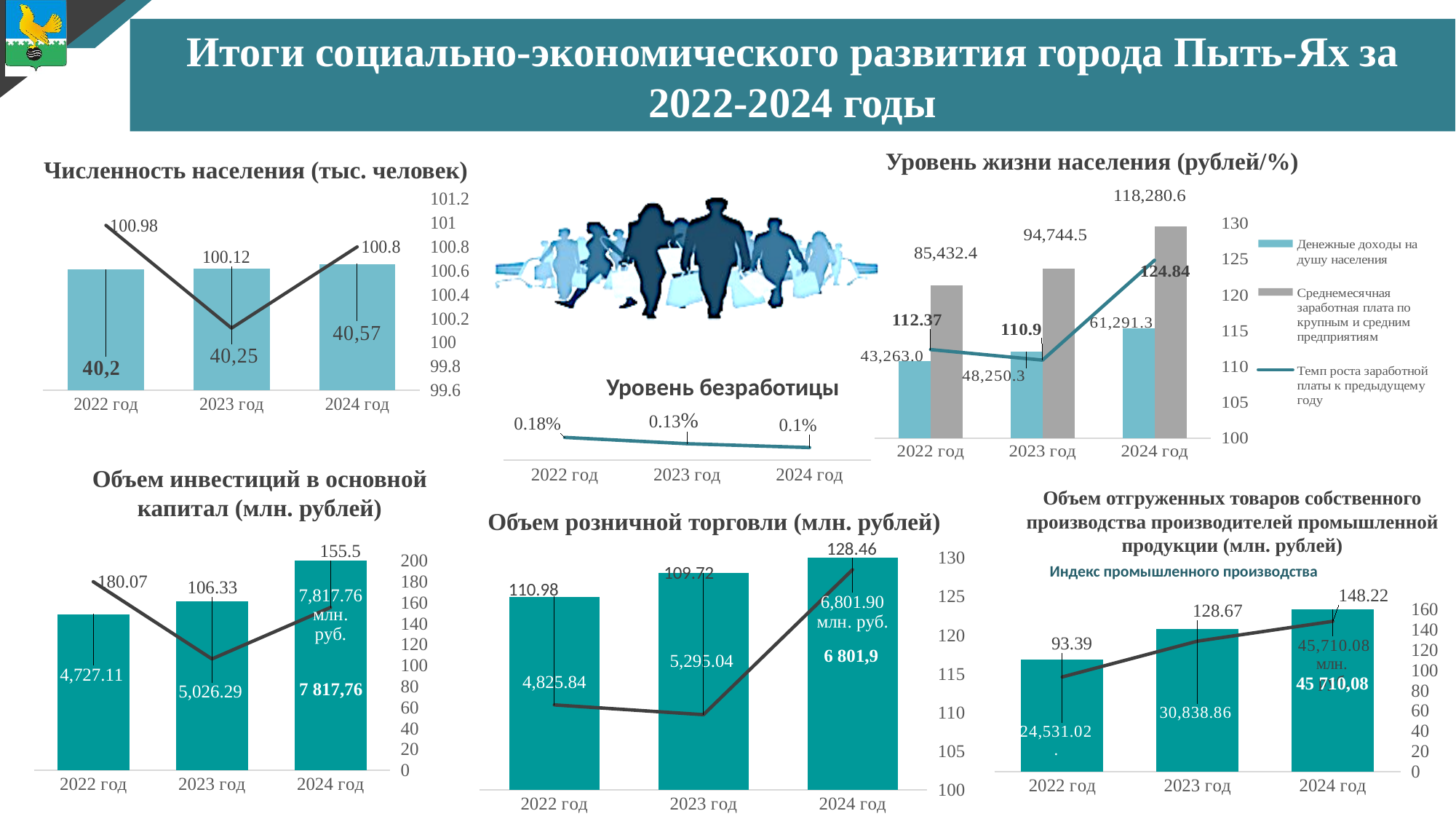
In the 'Уровень безработицы' chart, do the values rise or fall from 2022 год to 2024 год? fall In the 'Уровень жизни населения (рублей/%)' chart, how many series does the legend list? 3 In the 'Объем отгруженных товаров собственного производства' chart, what is the line value for 2024 год? 148.22 In the 'Уровень жизни населения (рублей/%)' chart, what is the value of 'Среднемесячная заработная плата по крупным и средним предприятиям' for 2024 год? 118,280.6 In the 'Объем инвестиций в основной капитал (млн. рублей)' chart, what is the bar value for 2023 год? 5,026.29 In the 'Уровень безработицы' chart, what is the value for 2023 год? 0.13% In the 'Численность населения (тыс. человек)' chart, what is the line value for 2022 год? 100.98 In the 'Численность населения (тыс. человек)' chart, what is the bar value for 2024 год? 40,57 How many year categories does the 'Объем отгруженных товаров собственного производства' chart show? 3 In the 'Объем розничной торговли (млн. рублей)' chart, what is the difference between the bar values for 2023 год and 2022 год? 469.20 In the 'Уровень жизни населения (рублей/%)' chart, which year has the lowest value of 'Денежные доходы на душу населения'? 2022 год In the 'Объем инвестиций в основной капитал (млн. рублей)' chart, which year has the highest line value? 2022 год